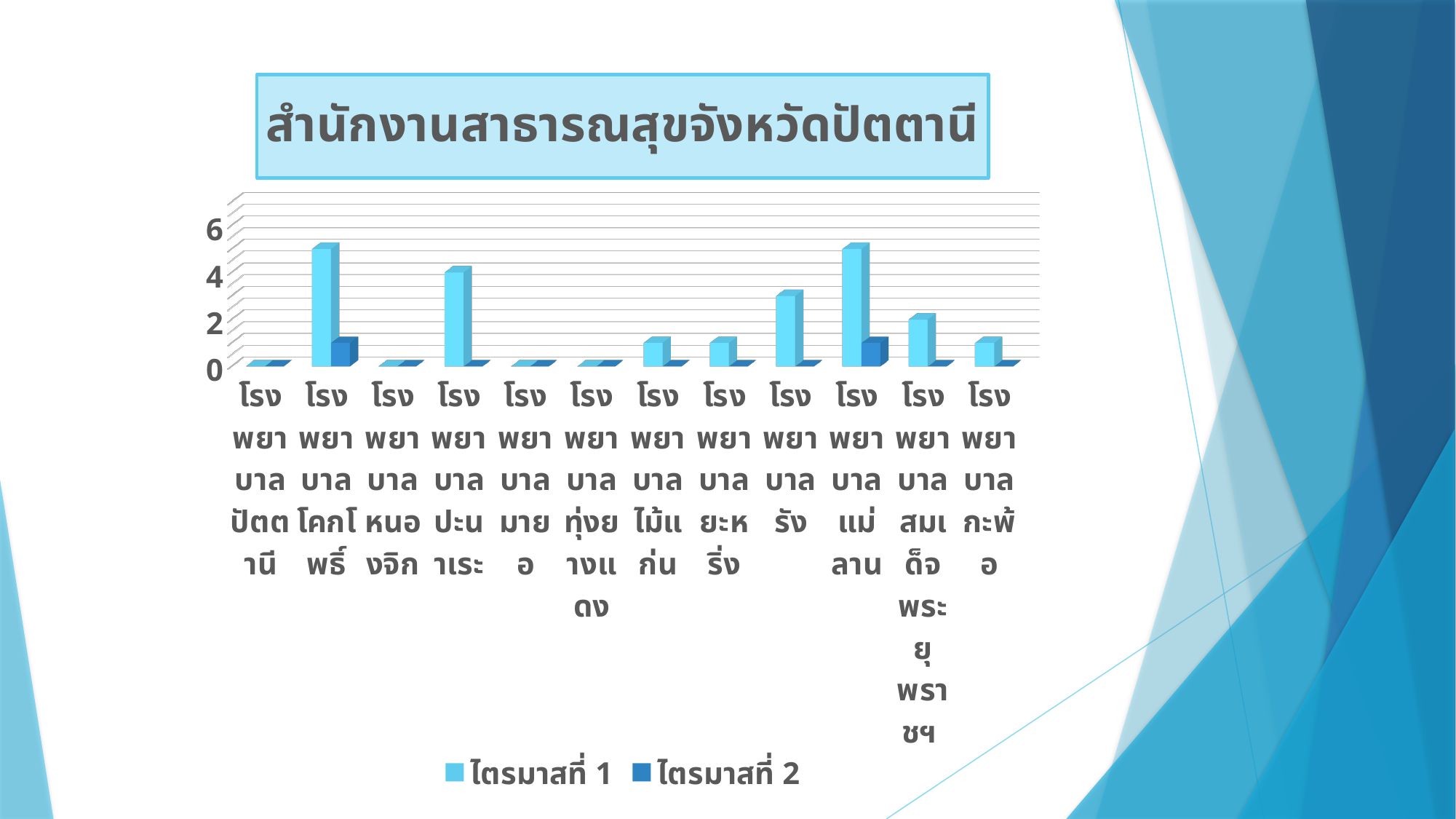
Which is larger for โรงพยาบาลโคกโพธิ์: the ไตรมาสที่ 1 value or the ไตรมาสที่ 2 value? ไตรมาสที่ 1 Is the ไตรมาสที่ 1 value for โรงพยาบาลสมเด็จพระยุพราชฯ greater or less than 4? less Is the ไตรมาสที่ 1 value for โรงพยาบาลรัง greater or less than 2? greater What is the title of the chart? สำนักงานสาธารณสุขจังหวัดปัตตานี Which hospital has the larger ไตรมาสที่ 1 value: โรงพยาบาลปะนาเระ or โรงพยาบาลรัง? โรงพยาบาลปะนาเระ Is the ไตรมาสที่ 1 value for โรงพยาบาลแม่ลาน greater or less than 4? greater What are the two series named in the legend? ไตรมาสที่ 1 and ไตรมาสที่ 2 How many series does the legend list? 2 How many hospitals (categories) are shown on the x axis? 12 What kind of chart is shown on the slide? bar chart